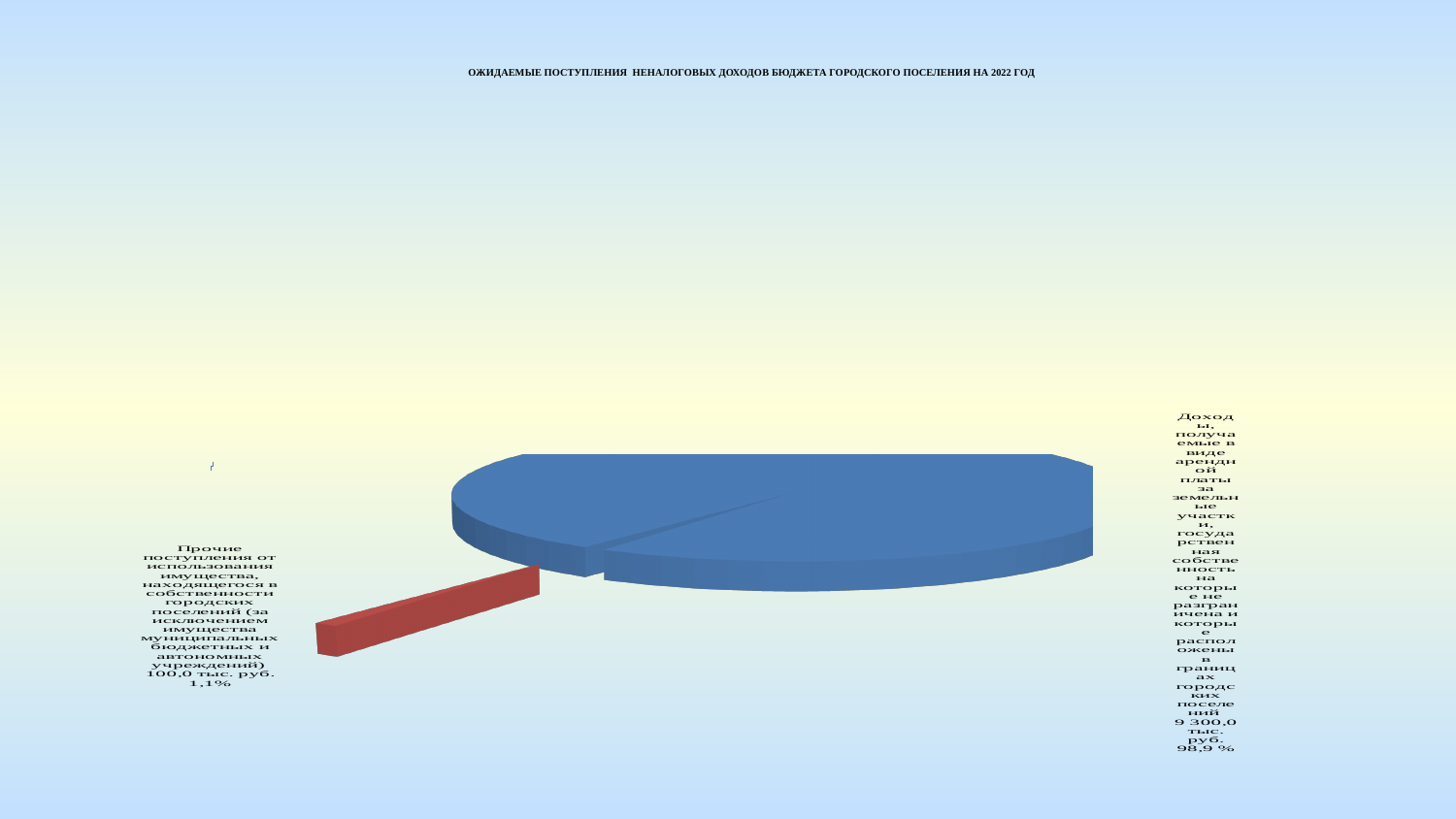
What kind of chart is shown on the slide? Pie chart How many slices does the pie chart have? 2 What is the value shown for the slice 'Доходы, получаемые в виде арендной платы за земельные участки'? 9 300,0 тыс. руб. Which slice of the pie chart is the largest? Доходы, получаемые в виде арендной платы за земельные участки What colour is the slice for 'Прочие поступления от использования имущества'? Red What share of the pie does the slice 'Прочие поступления от использования имущества' represent? 1,1% Which is larger: the value for 'Прочие поступления от использования имущества' or the value for 'Доходы, получаемые в виде арендной платы за земельные участки'? Доходы, получаемые в виде арендной платы за земельные участки Which slice of the pie chart is the smallest? Прочие поступления от использования имущества What is the title of the chart on the slide? ОЖИДАЕМЫЕ ПОСТУПЛЕНИЯ НЕНАЛОГОВЫХ ДОХОДОВ БЮДЖЕТА ГОРОДСКОГО ПОСЕЛЕНИЯ НА 2022 ГОД What share of the pie does the slice 'Доходы, получаемые в виде арендной платы за земельные участки' represent? 98,9 % What is the difference between the value for 'Доходы, получаемые в виде арендной платы за земельные участки' and the value for 'Прочие поступления от использования имущества'? 9 200,0 тыс. руб. What is the value shown for the slice 'Прочие поступления от использования имущества'? 100,0 тыс. руб.